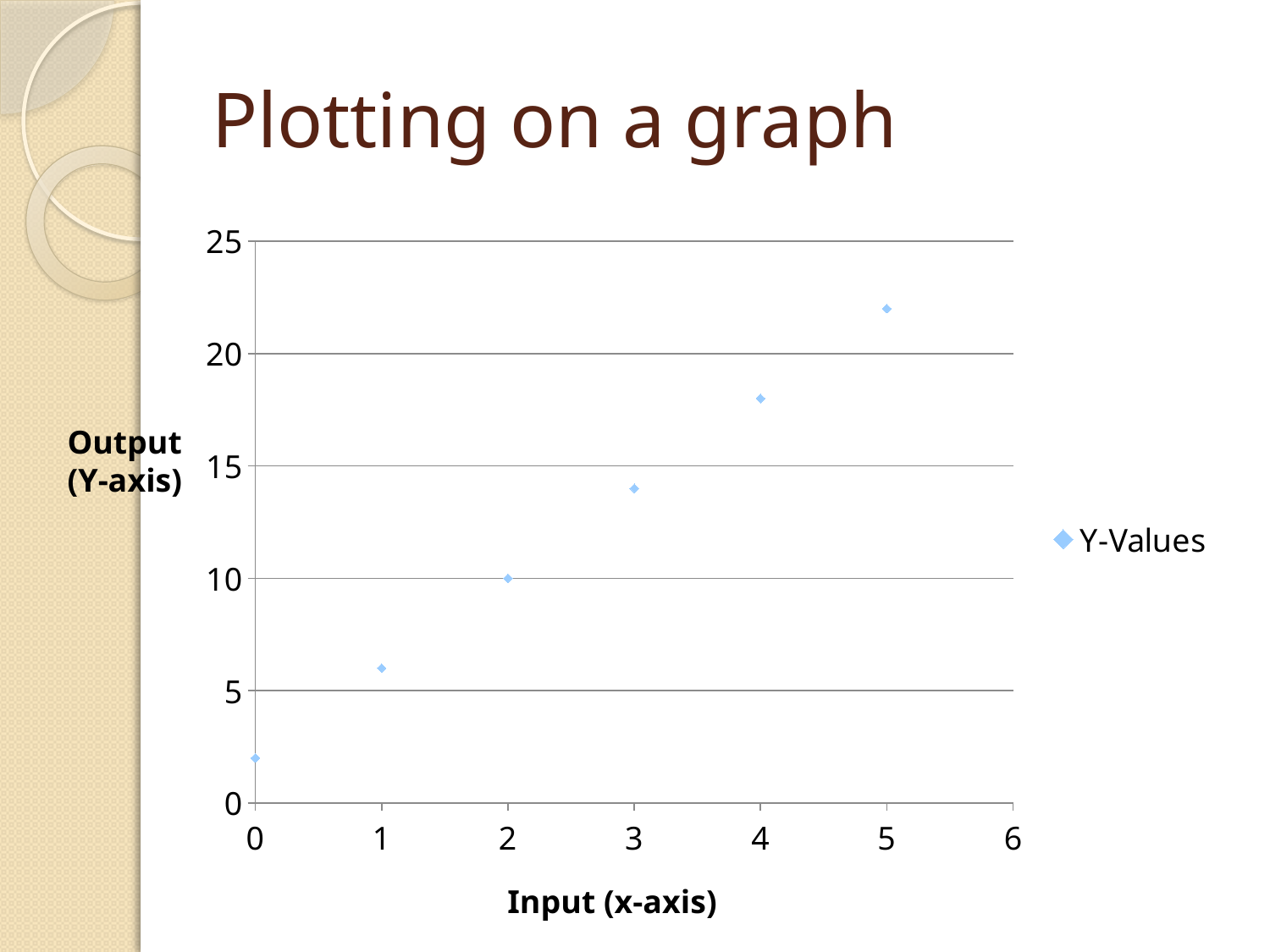
How many series does the legend list? 1 Which has the larger Y-Values output: input 4 or input 1? input 4 What is the Y-Values output at input 2? 10 What is the name of the series shown in the legend? Y-Values What kind of chart is shown on the slide? scatter chart How many data points are plotted on the chart? 6 Is the Y-Values output at input 5 greater or less than 20? greater Do the Y-Values rise or fall as the input increases along the x axis? rise Is the Y-Values output at input 1 greater or less than 5? greater At which input value is the Y-Values output lowest? 0 What is the title of the x axis? Input (x-axis) At which input value is the Y-Values output highest? 5